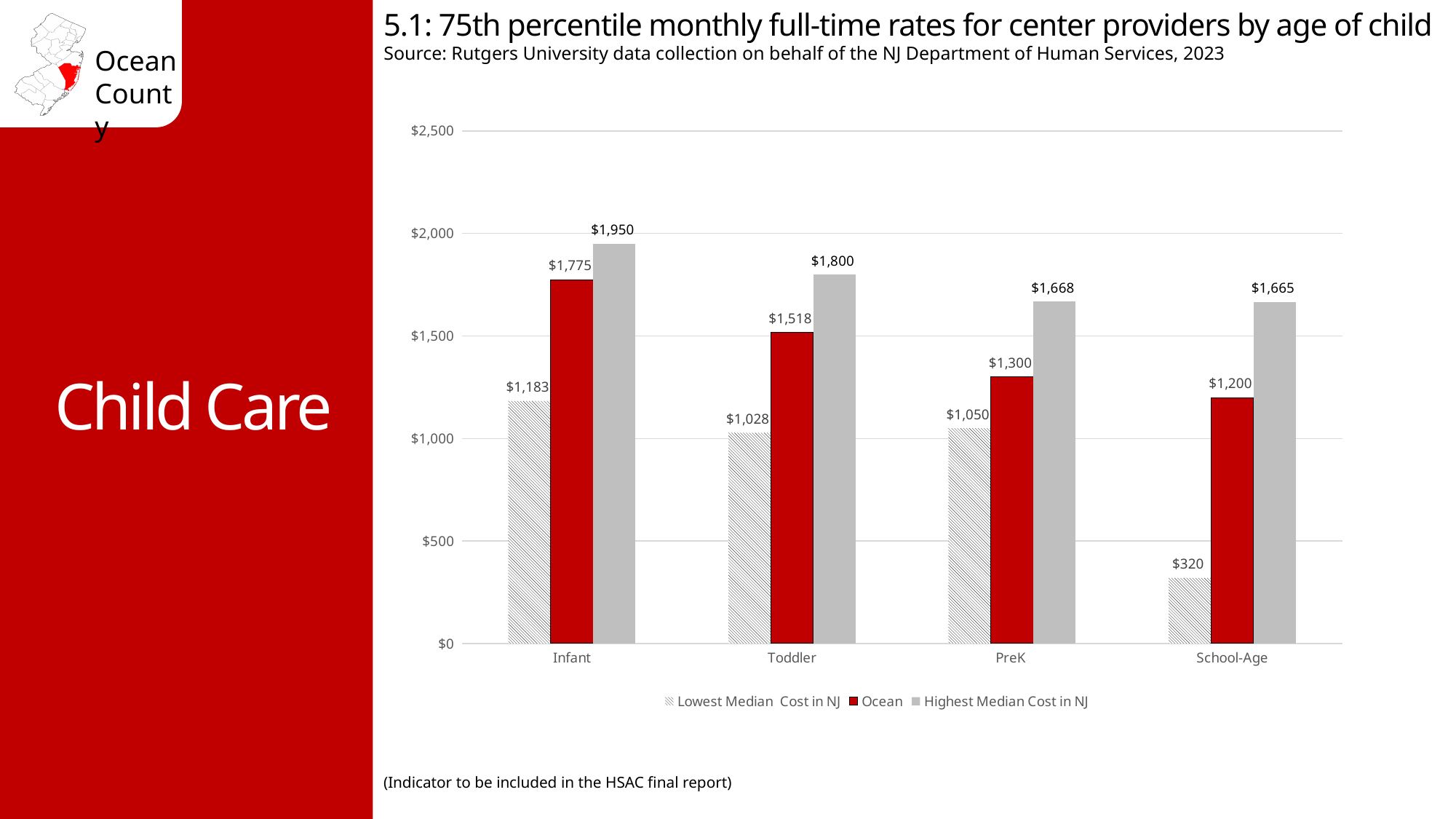
What kind of chart is shown? bar chart Which age group has the lowest Lowest Median Cost in NJ value? School-Age What is the Ocean value for Infant? $1,775 What is the Lowest Median Cost in NJ for School-Age? $320 Is the Ocean value for School-Age greater or less than $1,000? greater What is the difference between the Highest Median Cost in NJ and the Ocean value for PreK? $368 Which is larger: the Ocean value for Toddler or the Ocean value for PreK? Toddler How many series does the legend list? 3 Do the Ocean values rise or fall from Infant to School-Age? fall What is the Highest Median Cost in NJ for Toddler? $1,800 How many age groups are shown on the x axis? 4 Which age group has the highest Ocean value? Infant